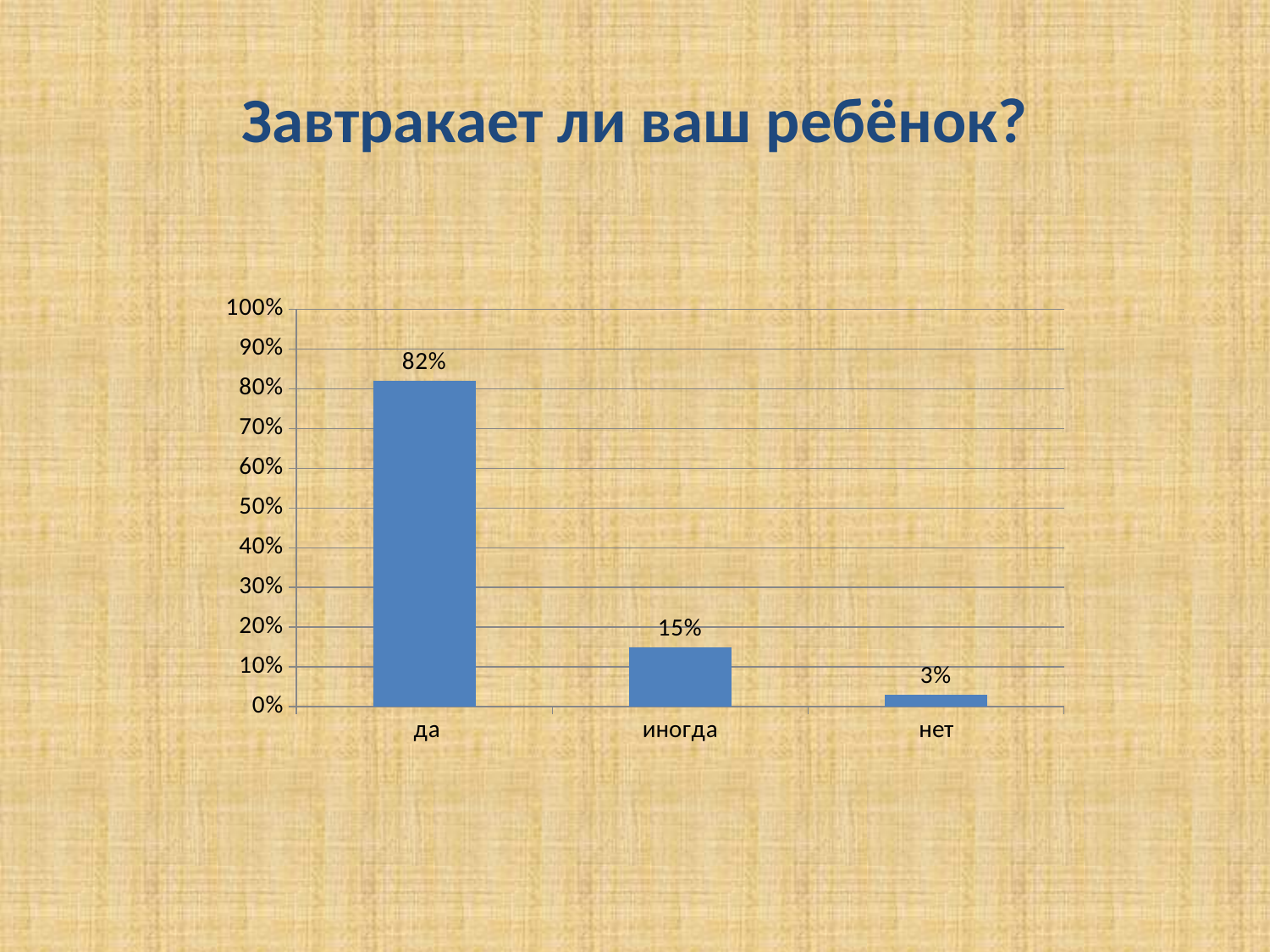
What is the difference between the values for "да" and "иногда"? 67% What is the value for "иногда"? 15% Is the value for "да" greater or less than 50%? greater Which category has the highest value? да What is the title of the slide? Завтракает ли ваш ребёнок? What is the difference between the values for "иногда" and "нет"? 12% What kind of chart is shown on the slide? bar chart What is the value for "нет"? 3% Which is larger, the value for "иногда" or the value for "нет"? иногда Which category has the lowest value? нет What is the value for "да"? 82% How many categories are shown on the x axis? 3